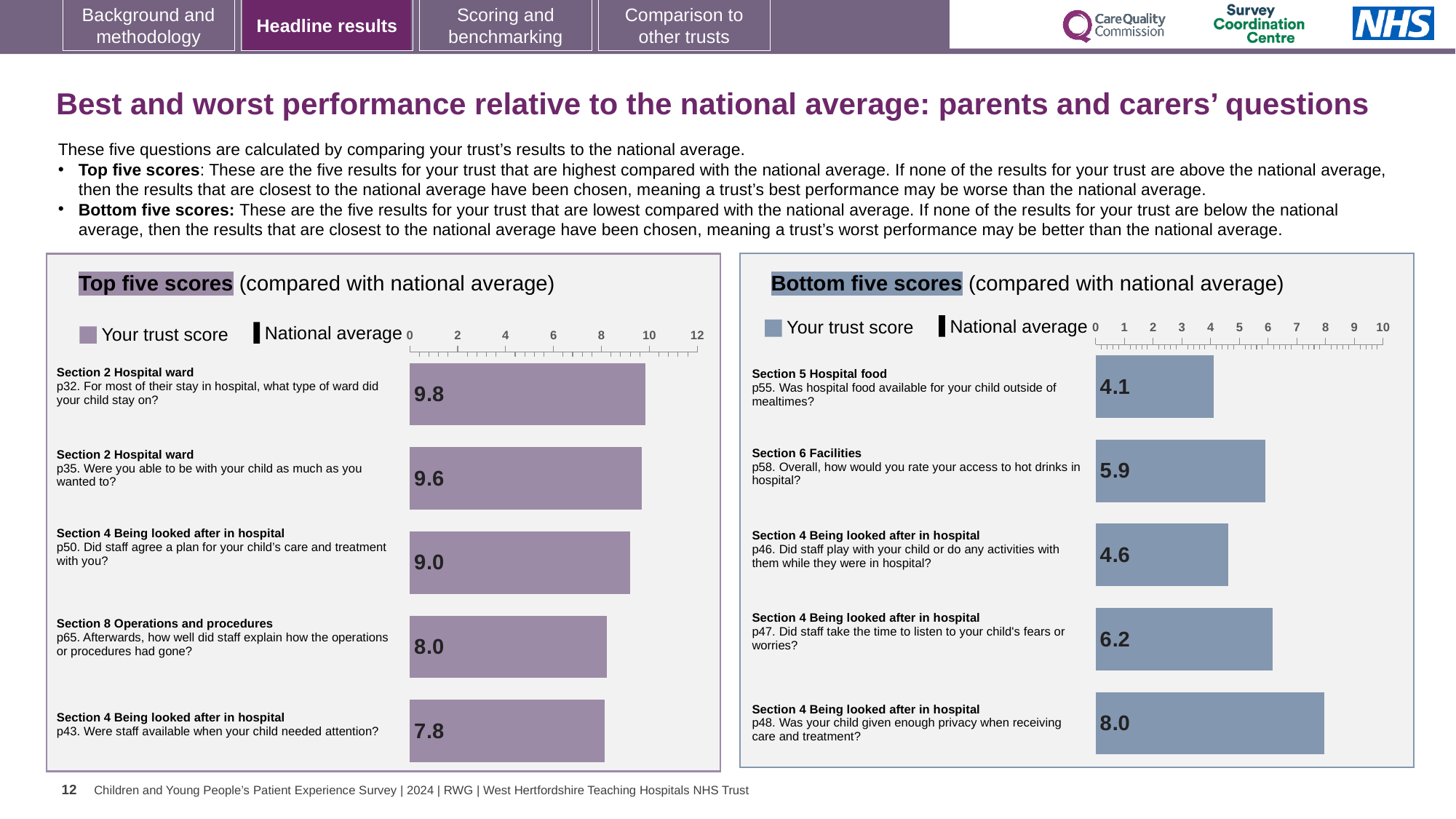
In the Top five scores chart, what is the difference between the trust scores for p32 and p43? 2.0 In the Top five scores chart, which question has the lowest trust score? p43. Were staff available when your child needed attention? In the Top five scores chart, what is the trust score for p65 (how well did staff explain how the operations or procedures had gone)? 8.0 In the Bottom five scores chart, which has the larger trust score: p58 (access to hot drinks) or p46 (did staff play with your child)? p58 (access to hot drinks) In the Bottom five scores chart, what is the trust score for p55 (was hospital food available for your child outside of mealtimes)? 4.1 In the Bottom five scores chart, which question has the lowest trust score? p55. Was hospital food available for your child outside of mealtimes? What type of chart is used in the Top five scores panel? Bar chart In the Top five scores chart, what is the trust score for p32 (what type of ward did your child stay on)? 9.8 In the Bottom five scores chart, what is the trust score for p47 (did staff take the time to listen to your child's fears or worries)? 6.2 In the Bottom five scores chart, which question has the highest trust score? p48. Was your child given enough privacy when receiving care and treatment? In the Top five scores chart, how many questions are plotted? 5 In the Bottom five scores chart, what is the difference between the trust scores for p48 and p55? 3.9